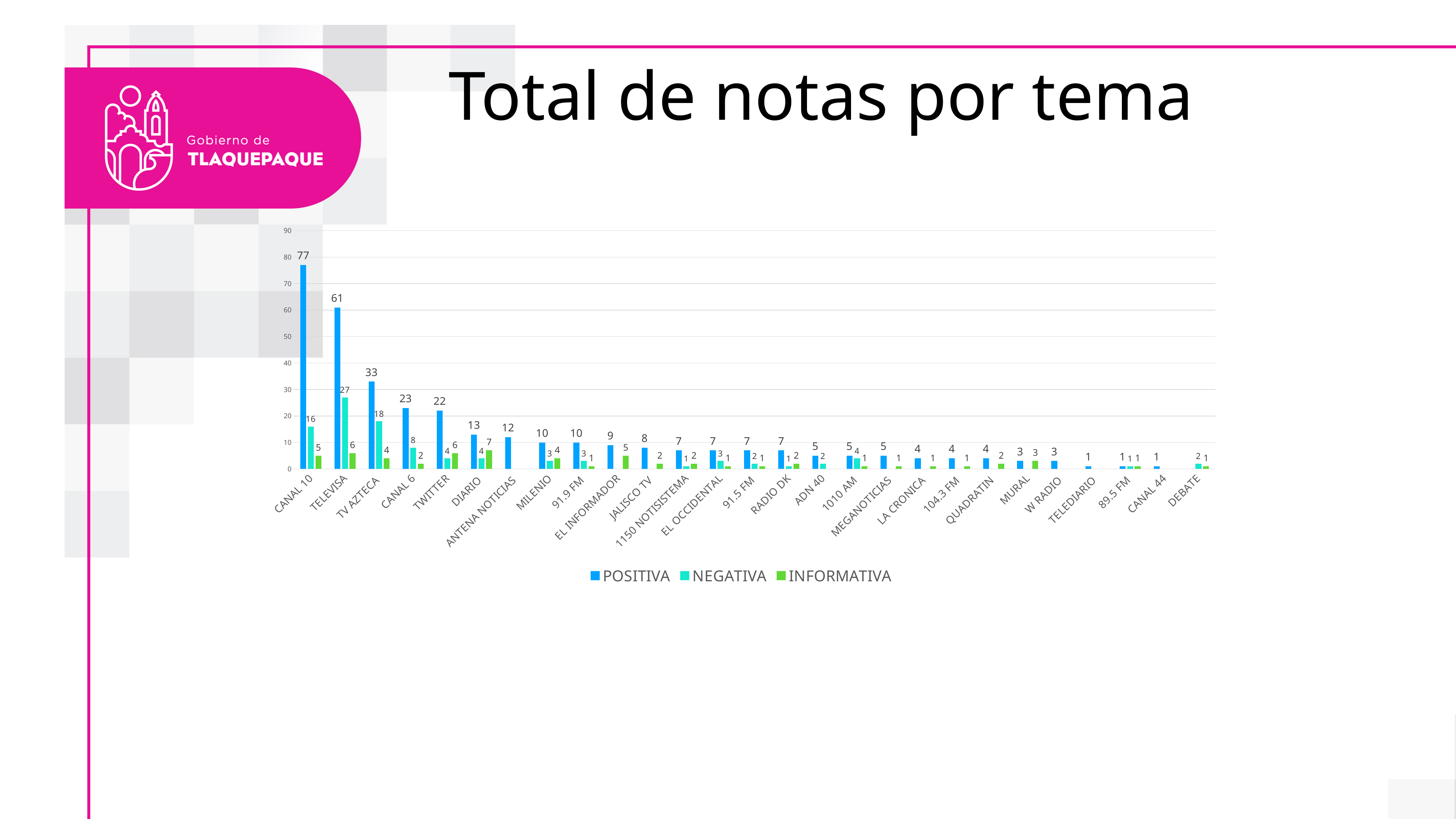
How many categories are shown on the x axis? 27 Do the POSITIVA values rise or fall from left to right along the x axis? Fall What kind of chart is shown on the slide? Bar chart What is the difference between the POSITIVA values for CANAL 10 and TELEVISA? 16 What is the title of the slide containing the chart? Total de notas por tema How many series does the legend list? 3 What is the INFORMATIVA value for DIARIO? 7 Which is larger, the POSITIVA value for TV AZTECA or the POSITIVA value for CANAL 6? TV AZTECA What is the NEGATIVA value for TELEVISA? 27 Which category has the highest NEGATIVA value? TELEVISA Which category has the highest POSITIVA value? CANAL 10 What is the POSITIVA value for CANAL 10? 77